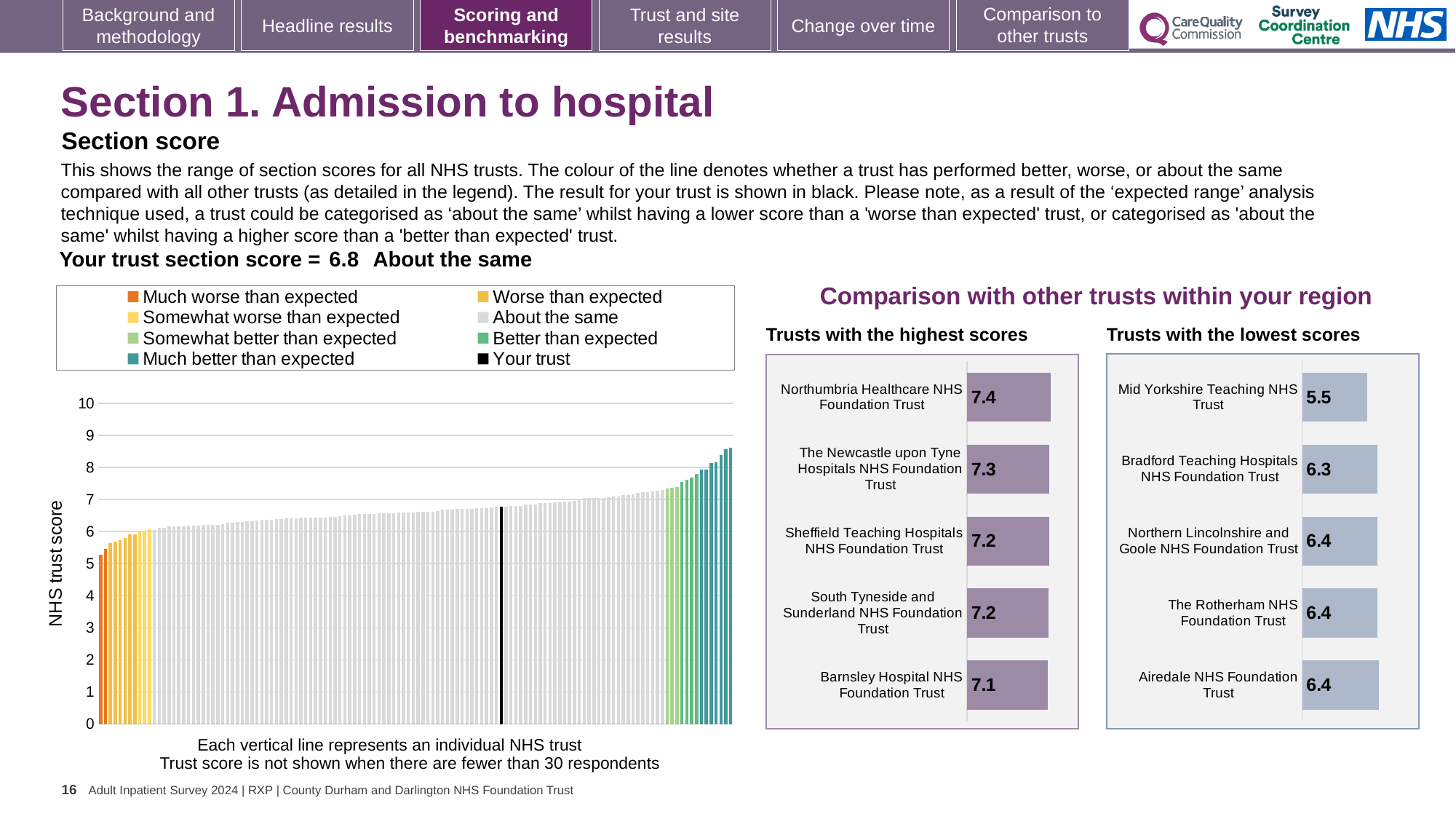
How many entries does the legend of the main chart on the left list? 8 In the 'Trusts with the highest scores' chart, which has a higher score: The Newcastle upon Tyne Hospitals NHS Foundation Trust or Sheffield Teaching Hospitals NHS Foundation Trust? The Newcastle upon Tyne Hospitals NHS Foundation Trust In the main chart on the left, do the trust scores rise or fall from left to right along the x axis? rise In the 'Trusts with the lowest scores' chart, which trust has the lowest score? Mid Yorkshire Teaching NHS Trust In the 'Trusts with the lowest scores' chart, what is the score for Mid Yorkshire Teaching NHS Trust? 5.5 In the 'Trusts with the highest scores' chart, what is the difference between the scores of Northumbria Healthcare NHS Foundation Trust and Barnsley Hospital NHS Foundation Trust? 0.3 In the 'Trusts with the lowest scores' chart, what is the difference between the scores of Bradford Teaching Hospitals NHS Foundation Trust and Mid Yorkshire Teaching NHS Trust? 0.8 In the main chart on the left showing all NHS trusts, what is the section score for your trust (the black line)? 6.8 In the 'Trusts with the highest scores' chart, what is the score for Northumbria Healthcare NHS Foundation Trust? 7.4 In the main chart on the left, is the value of the leftmost (lowest) trust bar greater or less than 6? less How many trusts are listed in the 'Trusts with the lowest scores' chart? 5 In the 'Trusts with the highest scores' chart, which trust has the lowest score shown? Barnsley Hospital NHS Foundation Trust